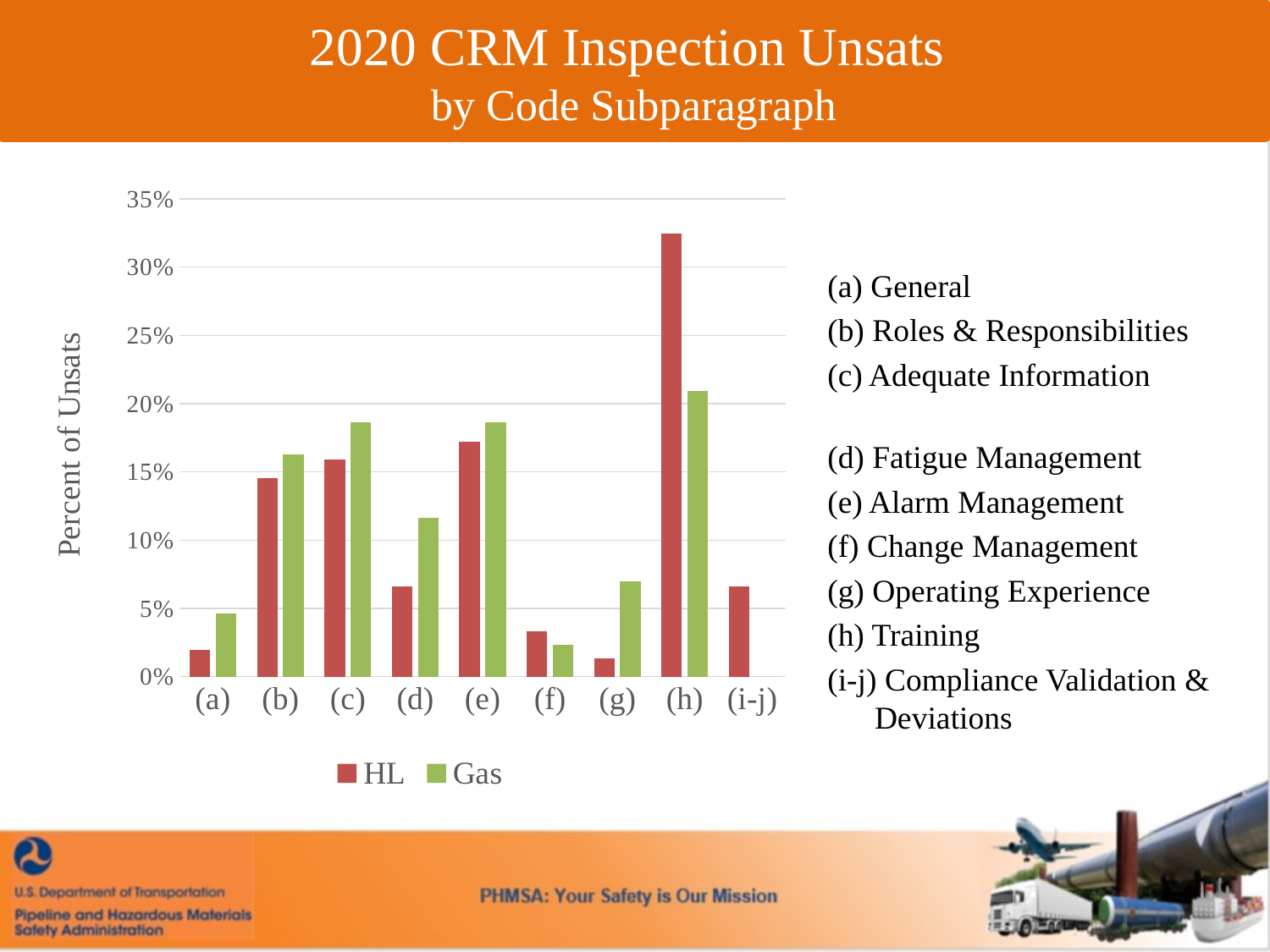
Is the HL value for (h) greater or less than 30%? greater Is the Gas value for (h) greater or less than 20%? greater Which category has the highest Gas value? (h) How many series does the legend list? 2 For category (h), which series has the larger value, HL or Gas? HL What kind of chart is shown on the slide? bar chart Is the Gas value for (d) greater or less than 10%? greater What is the title of the vertical axis? Percent of Unsats Which category has the highest HL value? (h) How many code subparagraph categories are shown on the x axis? 9 For category (d), which series has the larger value, HL or Gas? Gas